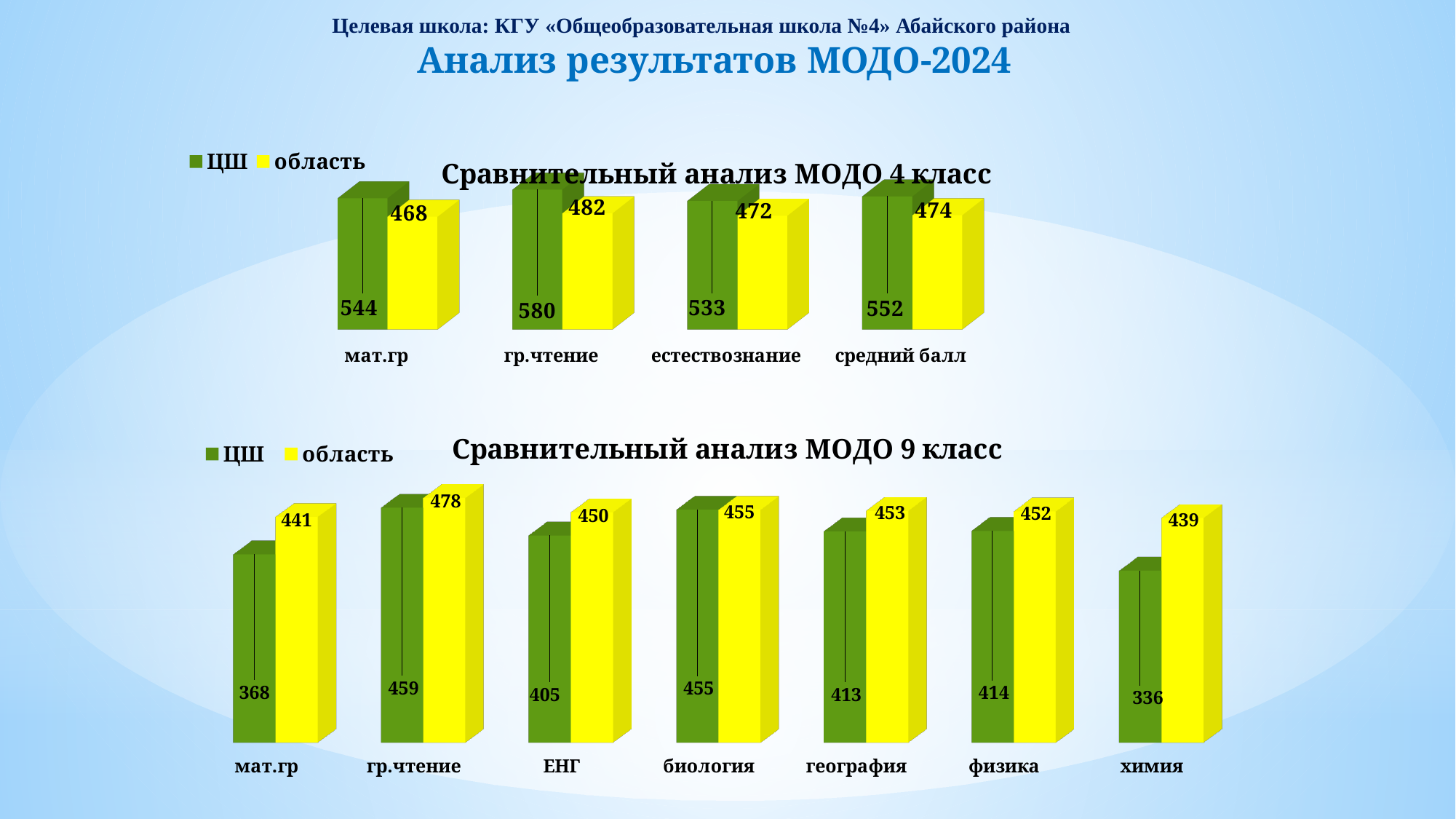
In the chart 'Сравнительный анализ МОДО 4 класс', what is the difference between ЦШ and область for средний балл? 78 In the chart 'Сравнительный анализ МОДО 9 класс', which category has the lowest ЦШ value? химия In the chart 'Сравнительный анализ МОДО 9 класс', which is larger for мат.гр: ЦШ or область? область In the chart 'Сравнительный анализ МОДО 4 класс', which category has the highest ЦШ value? гр.чтение In the chart 'Сравнительный анализ МОДО 4 класс', what is the value for ЦШ in гр.чтение? 580 In the chart 'Сравнительный анализ МОДО 9 класс', how many categories are shown on the x axis? 7 How many series does the legend of the chart 'Сравнительный анализ МОДО 9 класс' list? 2 In the chart 'Сравнительный анализ МОДО 9 класс', what is the difference between область and ЦШ for ЕНГ? 45 In the chart 'Сравнительный анализ МОДО 9 класс', what is the value for область in география? 453 In the chart 'Сравнительный анализ МОДО 4 класс', what is the value for область in естествознание? 472 In the chart 'Сравнительный анализ МОДО 4 класс', how many categories are shown on the x axis? 4 In the chart 'Сравнительный анализ МОДО 9 класс', what is the value for ЦШ in химия? 336